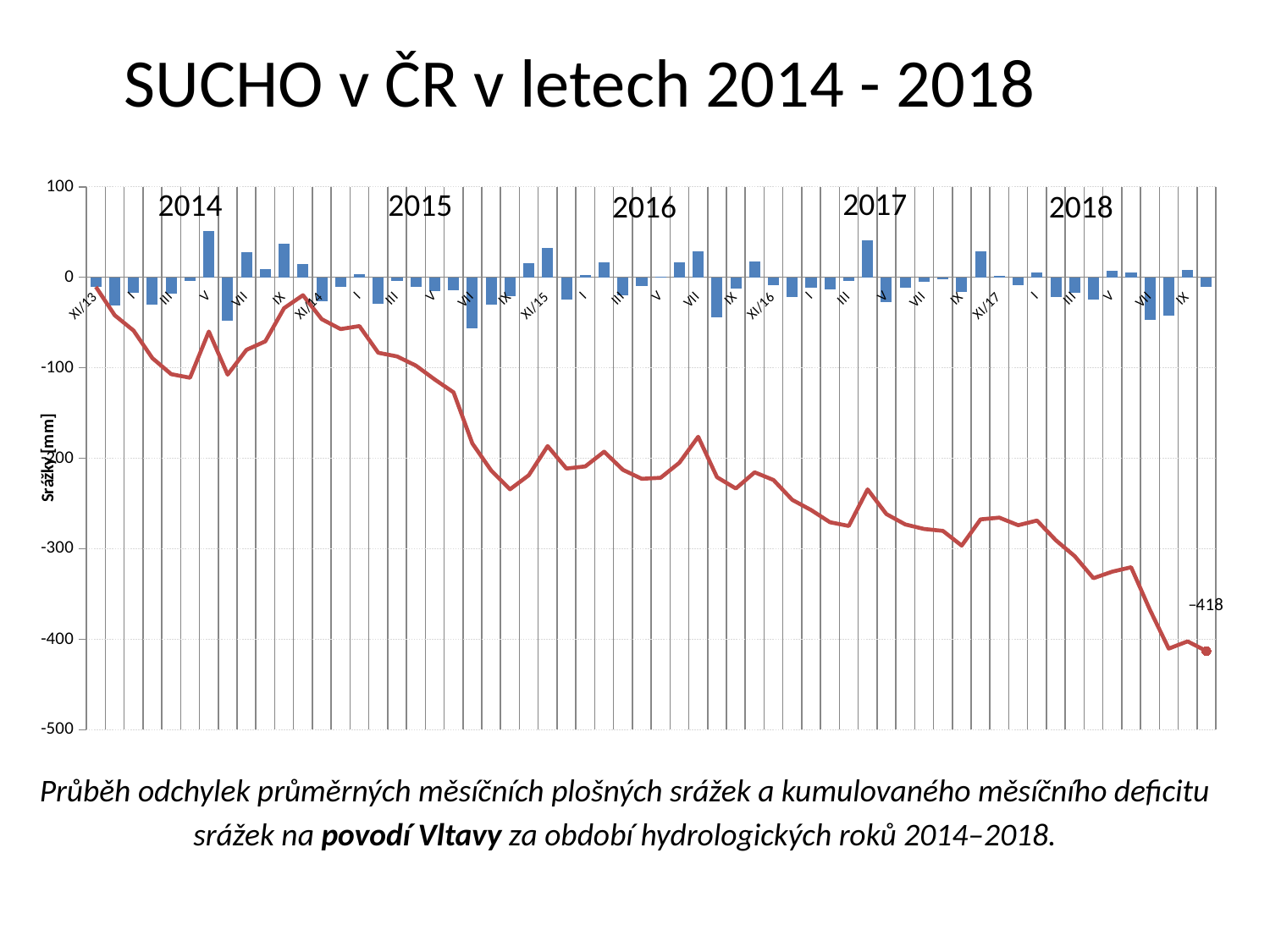
What is the lowest value shown on the vertical axis? -500 Is the final value of the red line greater or less than -400? less How many year labels are shown inside the chart area? 5 What is the title of the vertical axis? Srážky [mm] Does the red cumulative line generally rise or fall from XI/13 to the end of 2018? Fall Is the value of the red line at XI/14 greater or less than -100? greater What is the value printed at the end of the red cumulative deficit line? –418 Is the bar value for V in 2014 greater or less than 0? greater What kind of chart is shown on the slide? A combined bar and line chart